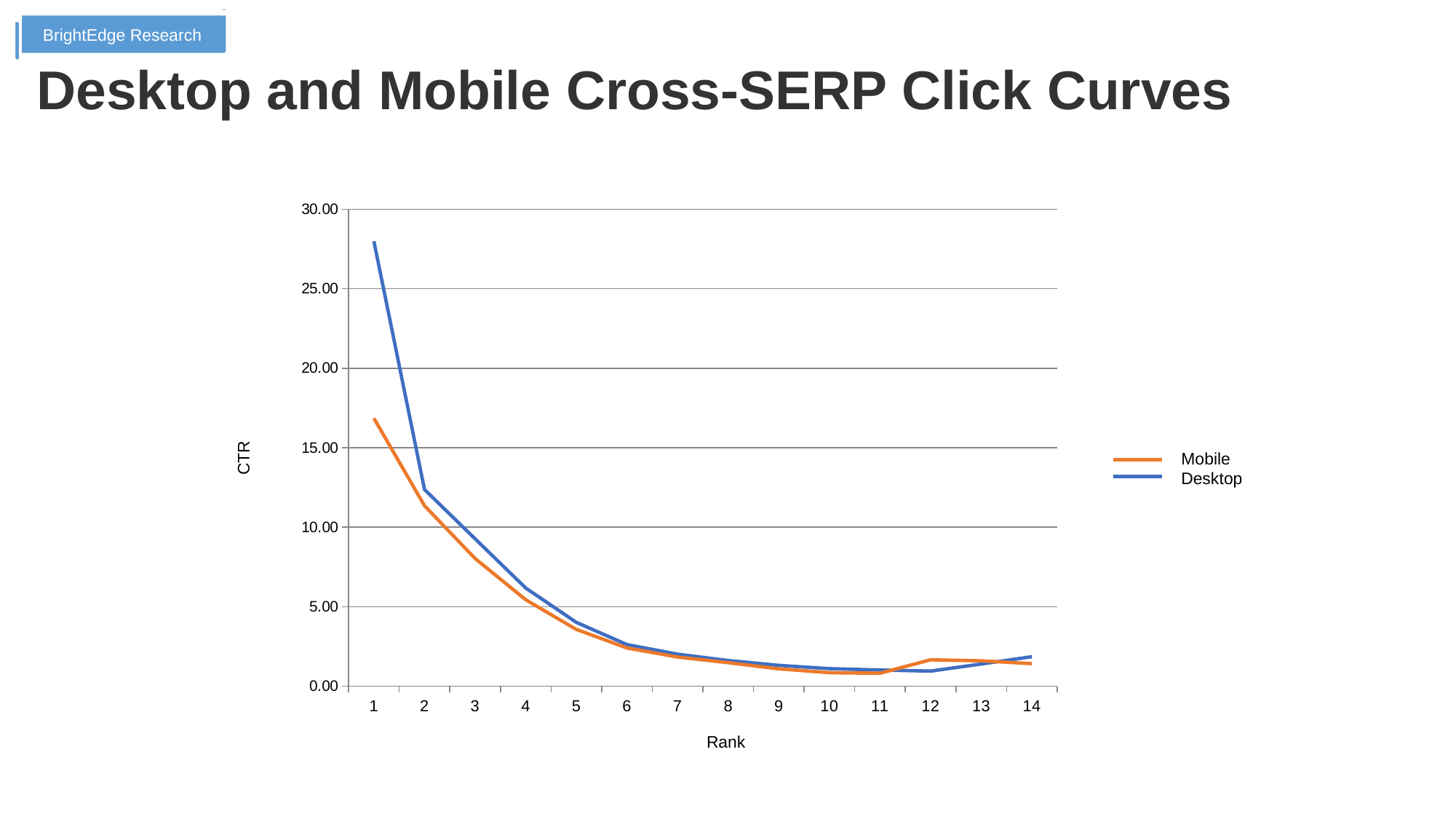
At rank 12, which series has the higher CTR, Mobile or Desktop? Mobile Is the Desktop CTR at rank 2 greater or less than 10.00? greater How many series does the legend list? 2 Is the Desktop CTR at rank 1 greater or less than 25.00? greater At which rank does the Desktop series reach its highest CTR? 1 Does the Desktop CTR rise or fall from rank 1 to rank 10? fall At rank 1, which series has the higher CTR, Desktop or Mobile? Desktop How many rank positions are plotted along the x axis? 14 What kind of chart is shown on the slide? Line chart Is the Mobile CTR at rank 1 greater or less than 20.00? less What is the label on the vertical axis of the chart? CTR